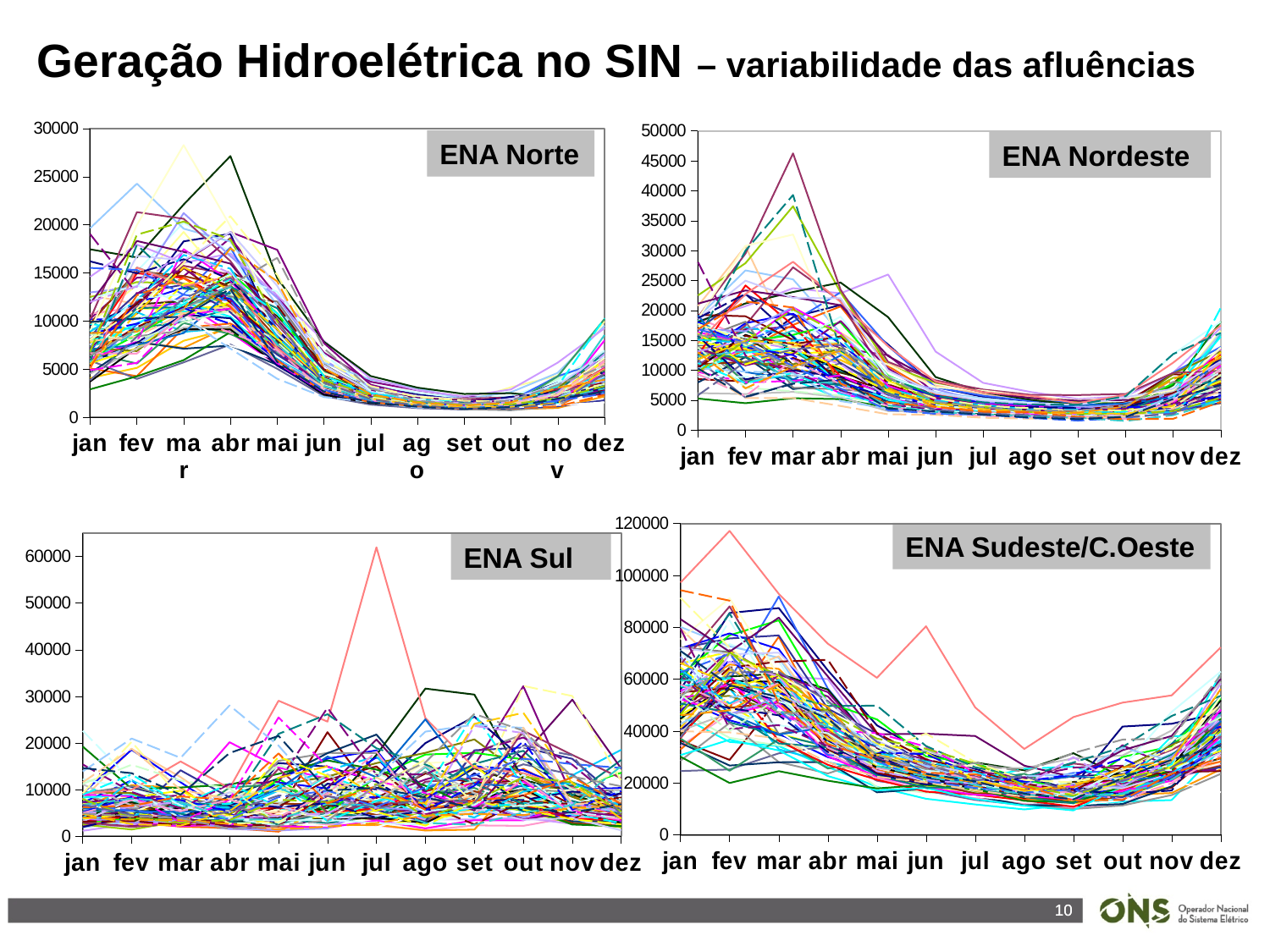
In the ENA Sudeste/C.Oeste chart, is the highest peak in fev greater or less than 100000? greater What kind of chart is the ENA Norte chart? line chart How many months are shown on the x axis of the ENA Sul chart? 12 What is the highest value shown on the y axis of the ENA Nordeste chart? 50000 In the ENA Nordeste chart, are the values in ago generally greater or less than 10000? less In the ENA Sudeste/C.Oeste chart, do the values generally rise or fall from set to dez? rise In the ENA Sul chart, is the highest peak in jul greater or less than 50000? greater What is the highest value shown on the y axis of the ENA Sudeste/C.Oeste chart? 120000 In the ENA Norte chart, do the values generally rise or fall from abr to ago? fall How many charts are on the slide? 4